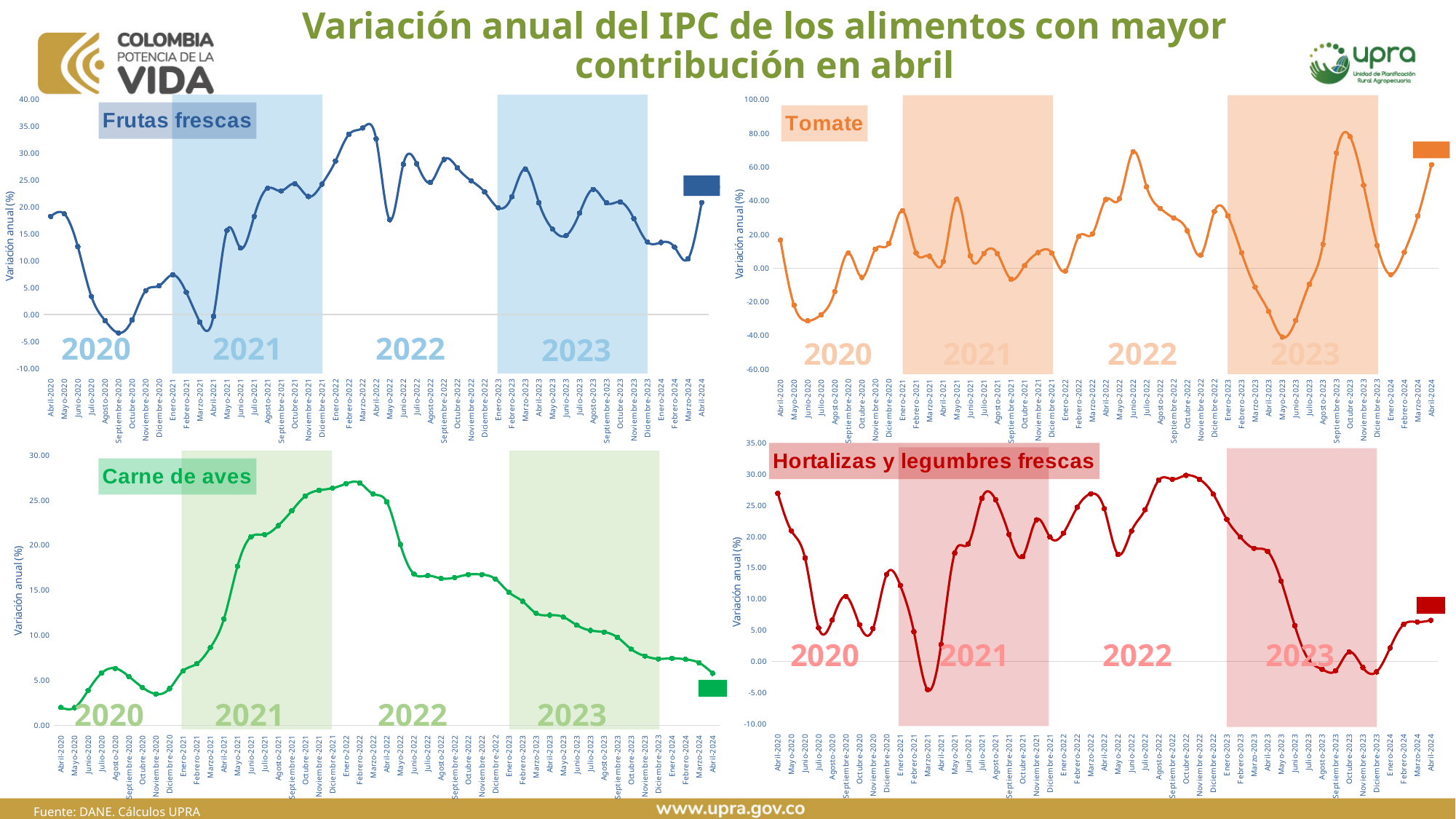
In the 'Hortalizas y legumbres frescas' chart, is the value for Octubre-2022 greater or less than 25.00? greater In the 'Hortalizas y legumbres frescas' chart, is the value for Marzo-2021 greater or less than 0.00? less In the 'Tomate' chart, is the value for Octubre-2023 greater or less than 60.00? greater In the 'Frutas frescas' chart, which is larger, the value for Abril-2022 or the value for Abril-2024? Abril-2022 In the 'Carne de aves' chart, do the values rise or fall from Febrero-2022 to Abril-2024? Fall What kind of chart is the 'Frutas frescas' chart? Line chart Which chart on the slide is drawn with an orange line? Tomate